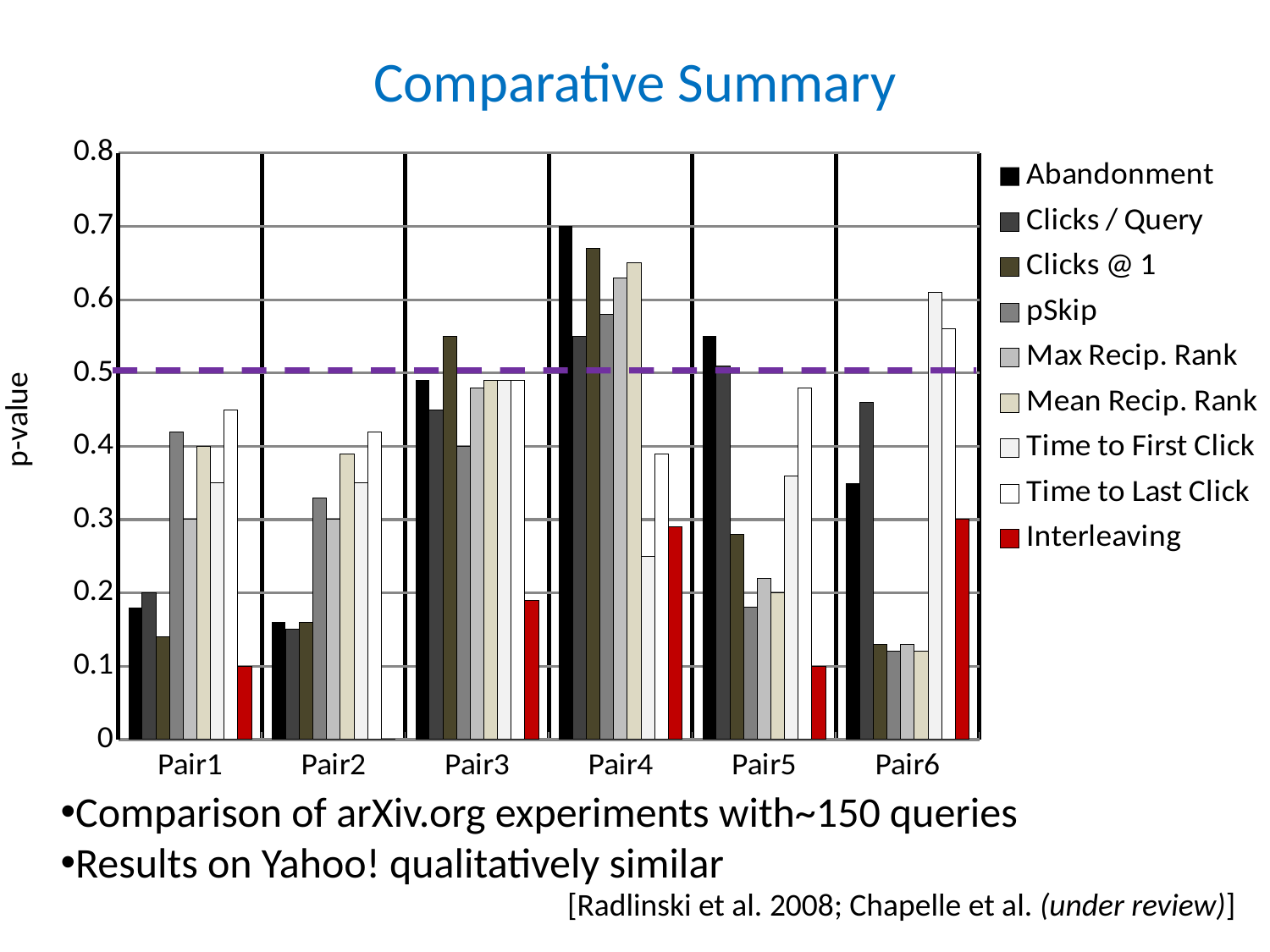
How many pairs (categories) are shown on the x axis? 6 Is the Interleaving value for Pair4 greater or less than 0.2? greater Is the Time to First Click value for Pair6 greater or less than 0.5? greater Which is larger, the Abandonment value for Pair4 or for Pair1? Pair4 For Pair3, which is larger, the Clicks @ 1 value or the Interleaving value? Clicks @ 1 Is the Interleaving value for Pair1 greater or less than 0.2? less Which pair has the highest Abandonment value? Pair4 How many series does the legend list? 9 What kind of chart is shown on the slide? bar chart What is the label on the y axis? p-value Which pair has the lowest Time to First Click value? Pair4